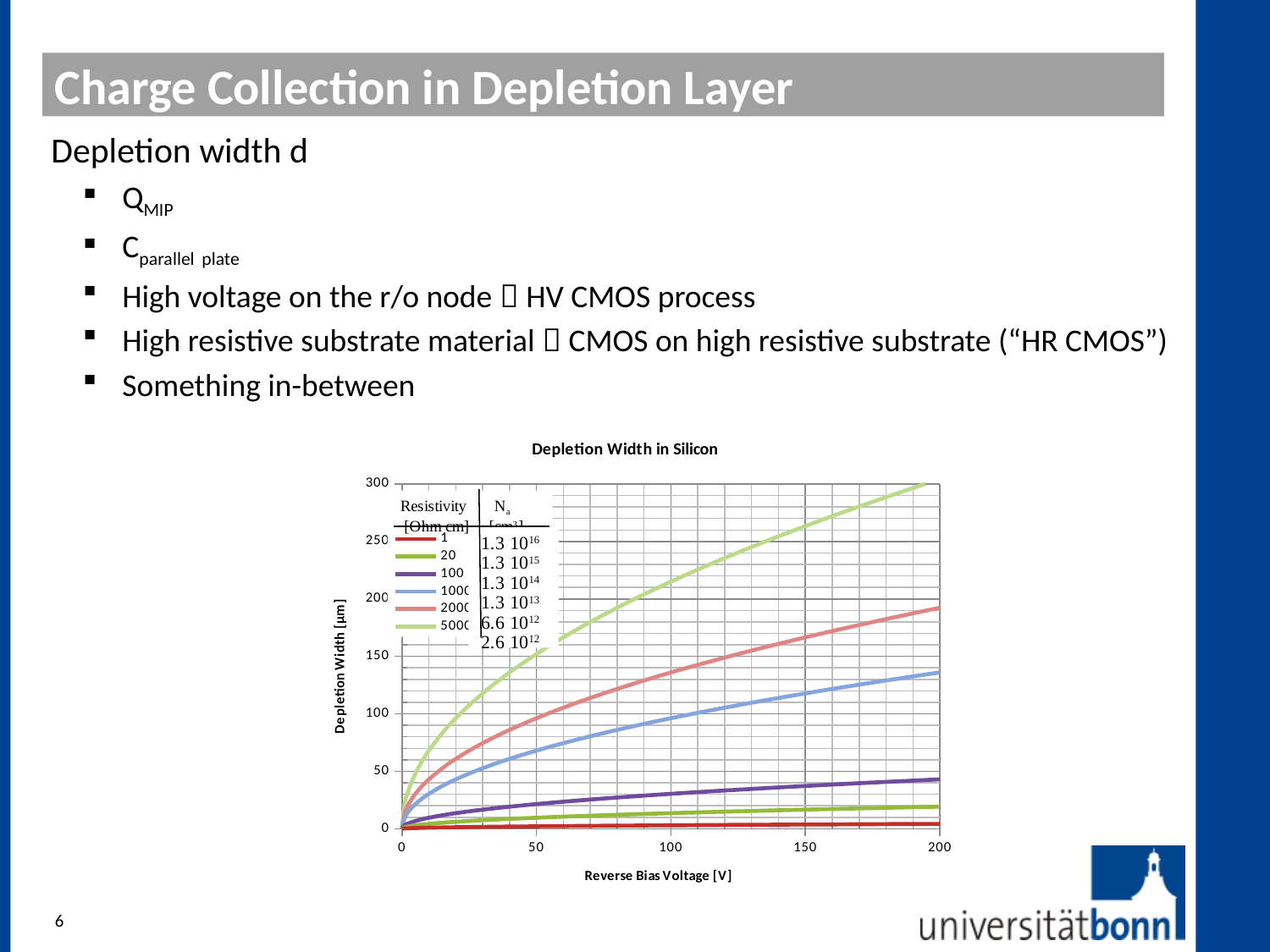
What is the title of the chart? Depletion Width in Silicon Is the depletion width for the 100 Ohm cm series at 200 V greater or less than 50? less Is the depletion width for the 1000 Ohm cm series at 200 V greater or less than 150? less At 200 V, which series has the larger depletion width, 2000 Ohm cm or 1000 Ohm cm? 2000 What is the label of the x axis of the chart? Reverse Bias Voltage [V] Is the depletion width for the 1000 Ohm cm series at 200 V greater or less than 100? greater Do the depletion width curves rise or fall as the reverse bias voltage increases? rise How many series does the chart's legend list? 6 Which resistivity series reaches the highest depletion width on the chart? 5000 What kind of chart is shown on the slide? line chart Which resistivity series has the lowest depletion width across the chart? 1